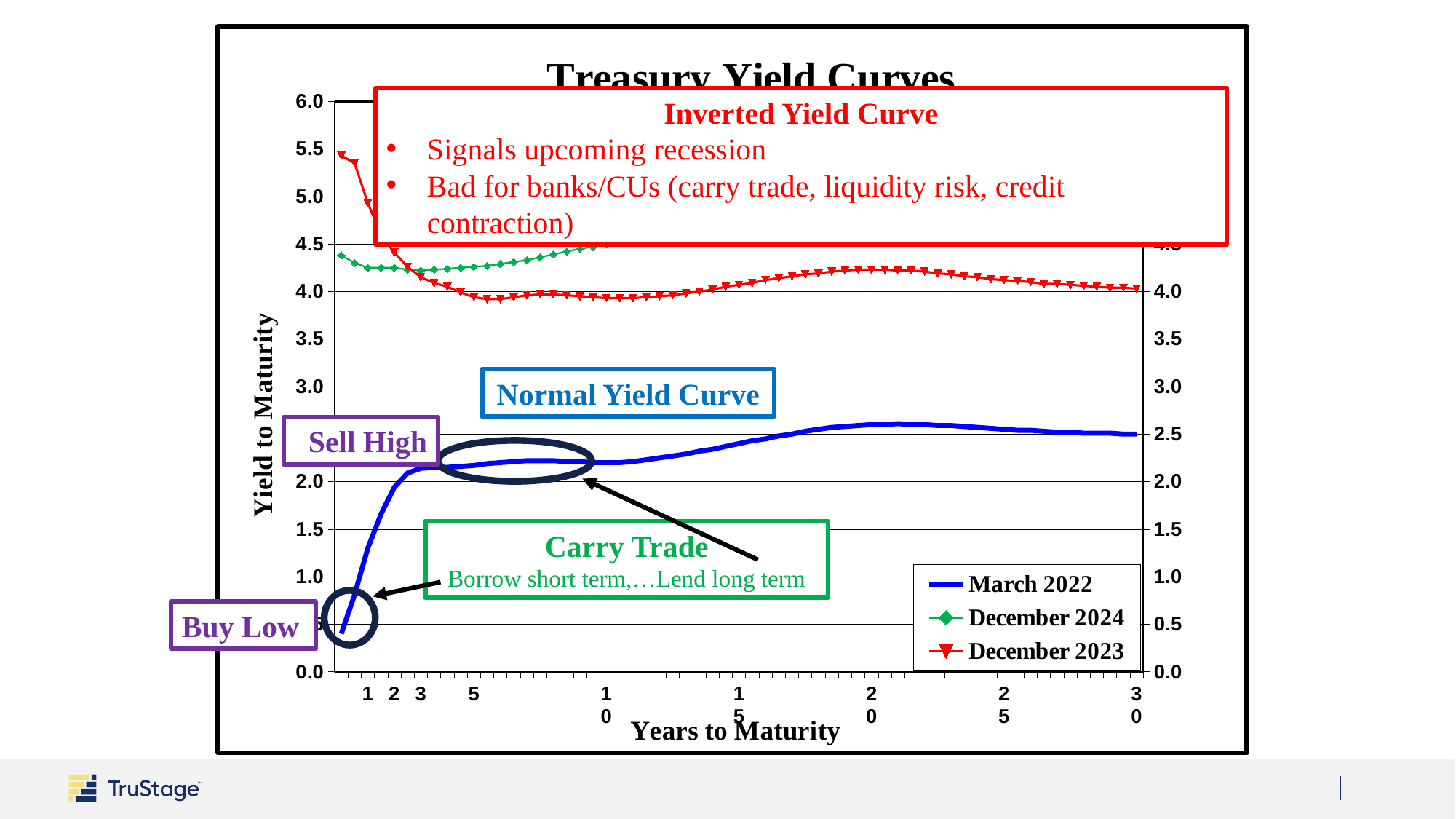
Is the December 2024 value at 1 year to maturity greater or less than 4.0? greater Is the December 2023 value at 30 years to maturity greater or less than 3.5? greater How many series does the legend list? 3 At 5 years to maturity, which is higher: March 2022 or December 2024? December 2024 At 30 years to maturity, which is higher: March 2022 or December 2023? December 2023 What is the title of the chart? Treasury Yield Curves Does the March 2022 curve rise or fall between 1 and 5 years to maturity? rise What kind of chart is shown on the slide? line chart Is the March 2022 value at 30 years to maturity greater or less than 3.0? less What is the label of the x axis? Years to Maturity Does the December 2023 curve rise or fall between 1 and 5 years to maturity? fall